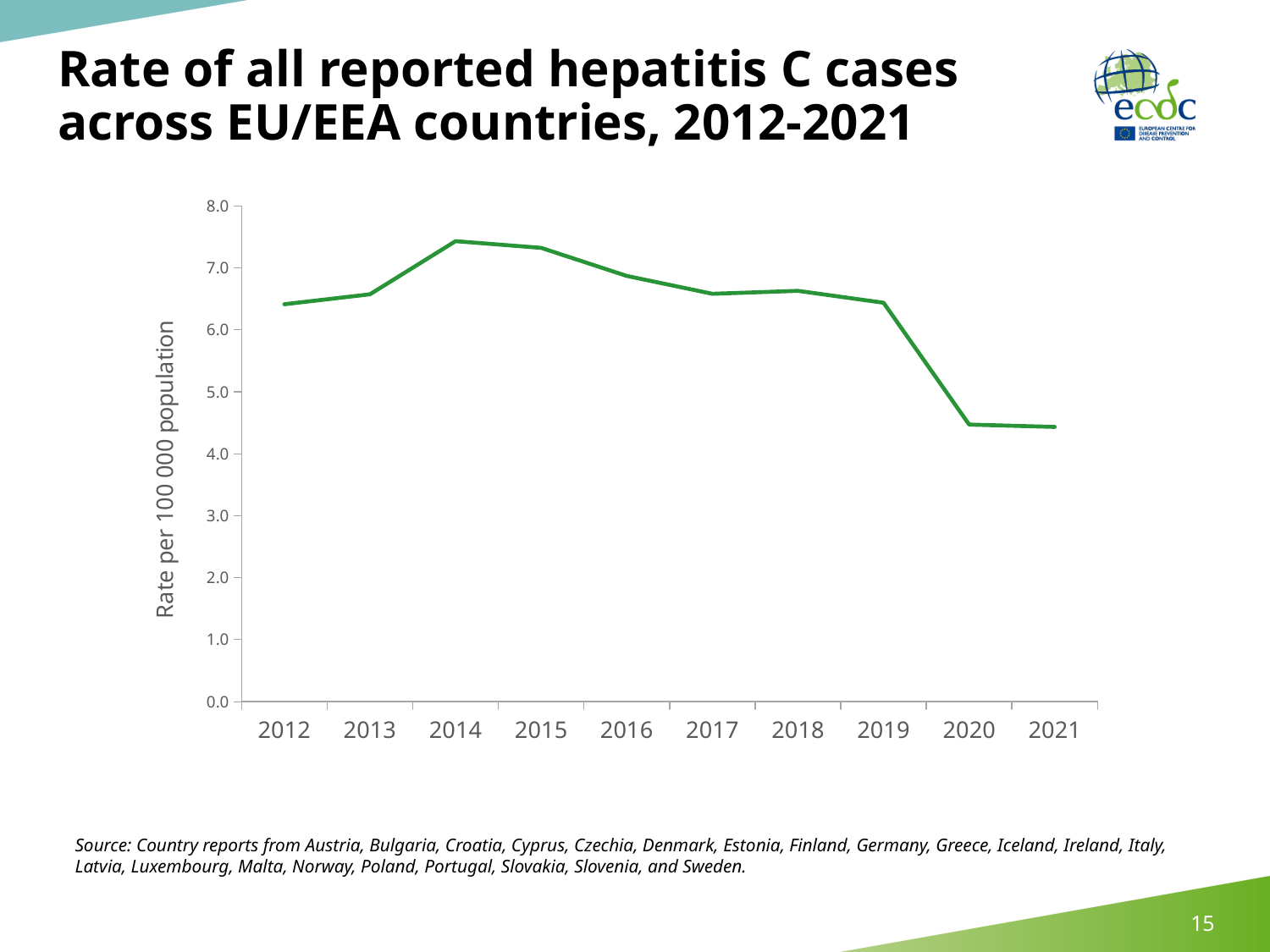
Which year has the higher rate, 2016 or 2019? 2016 Overall, does the rate rise or fall from 2012 to 2021? Fall Is the rate for 2020 greater or less than 5.0? less What kind of chart is shown on the slide? Line chart How many years are plotted along the x axis of the chart? 10 Which year has the higher rate, 2014 or 2020? 2014 Is the rate for 2021 greater or less than 5.0? less Is the rate for 2012 greater or less than 6.0? greater What is the label on the y axis of the chart? Rate per 100 000 population